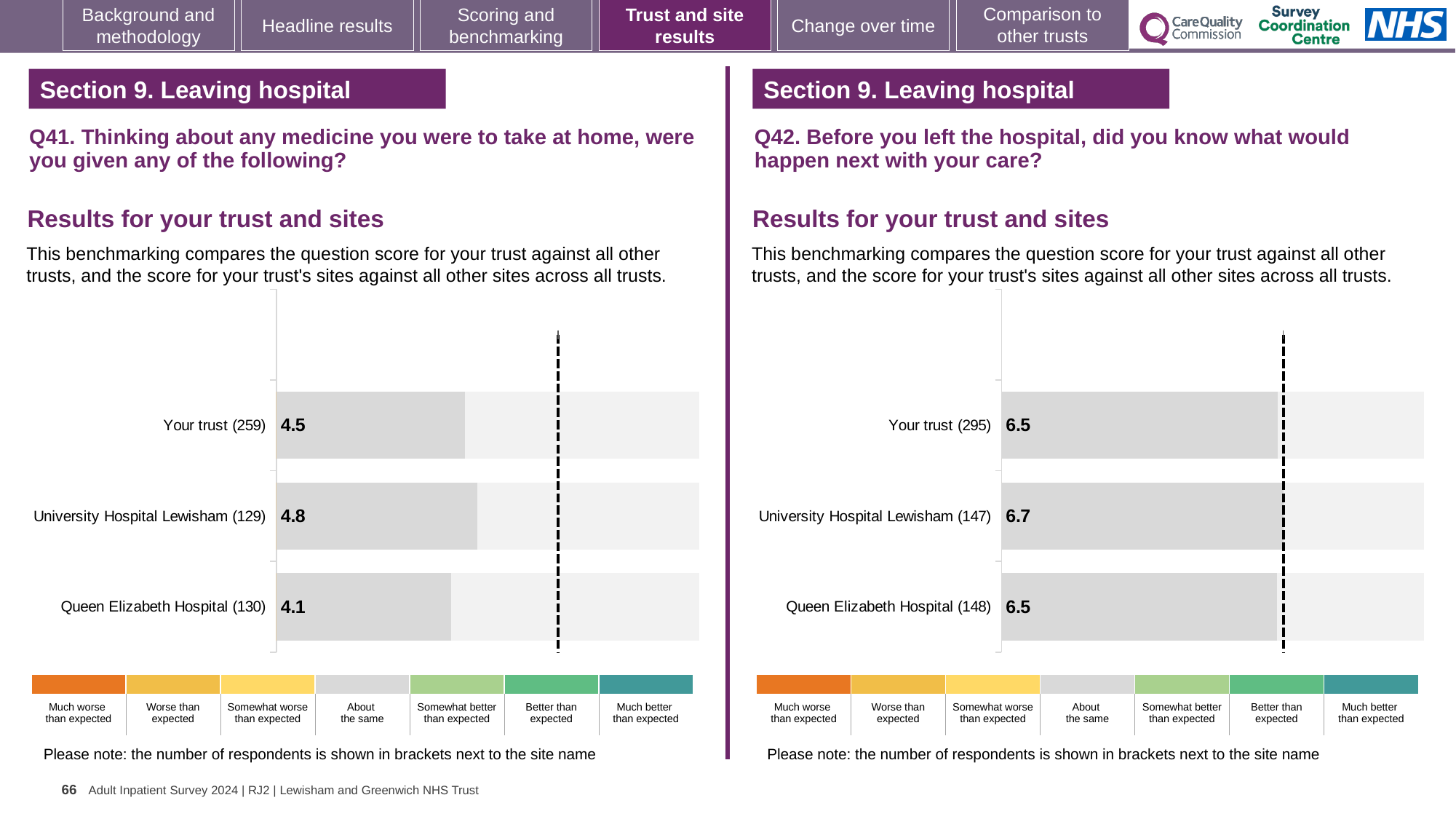
On the Q42 chart (right), which site or trust has the highest score? University Hospital Lewisham On the Q41 chart (left), what is the score for Queen Elizabeth Hospital? 4.1 What kind of chart is used on the Q42 chart (right)? Bar chart On the Q41 chart (left), what is the score for Your trust? 4.5 On the Q42 chart (right), what is the difference between the scores for University Hospital Lewisham and Your trust? 0.2 On the Q41 chart (left), which site or trust has the lowest score? Queen Elizabeth Hospital On the Q41 chart (left), how many respondents are shown in brackets for Your trust? 259 On the Q41 chart (left), what is the difference between the scores for University Hospital Lewisham and Queen Elizabeth Hospital? 0.7 On the Q42 chart (right), what is the score for Your trust? 6.5 On the Q41 chart (left), which site or trust has the highest score? University Hospital Lewisham On the Q41 chart (left), how many bars are plotted? 3 On the Q42 chart (right), what is the score for University Hospital Lewisham? 6.7